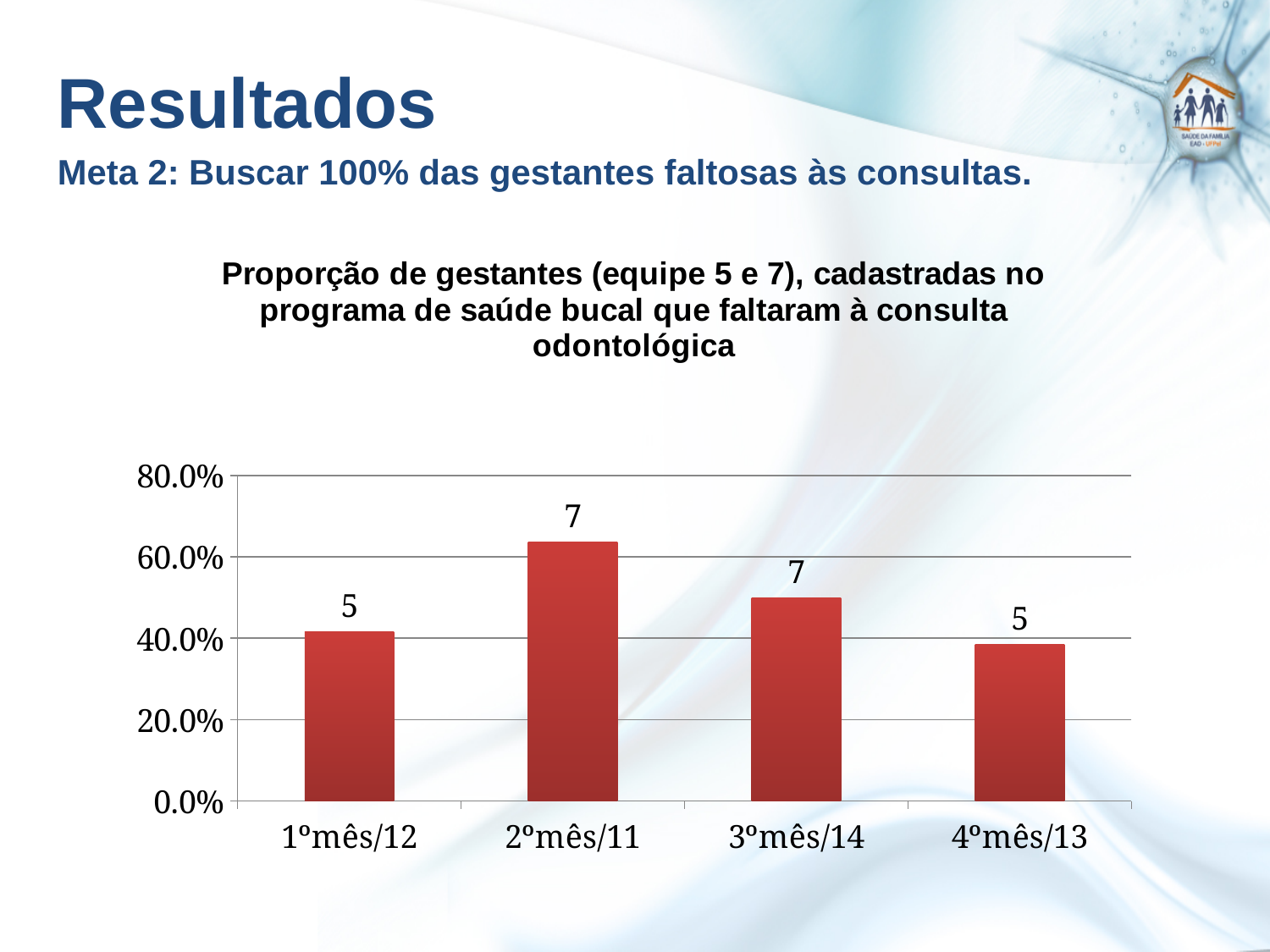
Which bar is taller, 2ºmês/11 or 3ºmês/14? 2ºmês/11 What data label is printed above the bar for 2ºmês/11? 7 Which category has the tallest bar? 2ºmês/11 What colour are the bars in the chart? red Is the value for 3ºmês/14 greater or less than 40.0%? greater How many categories are shown on the x axis of the chart? 4 Is the value for 2ºmês/11 greater or less than 60.0%? greater What data label is printed above the bar for 1ºmês/12? 5 Do the bar values rise or fall from 2ºmês/11 to 4ºmês/13? fall What type of chart is shown on the slide? bar chart What data label is printed above the bar for 4ºmês/13? 5 What data label is printed above the bar for 3ºmês/14? 7